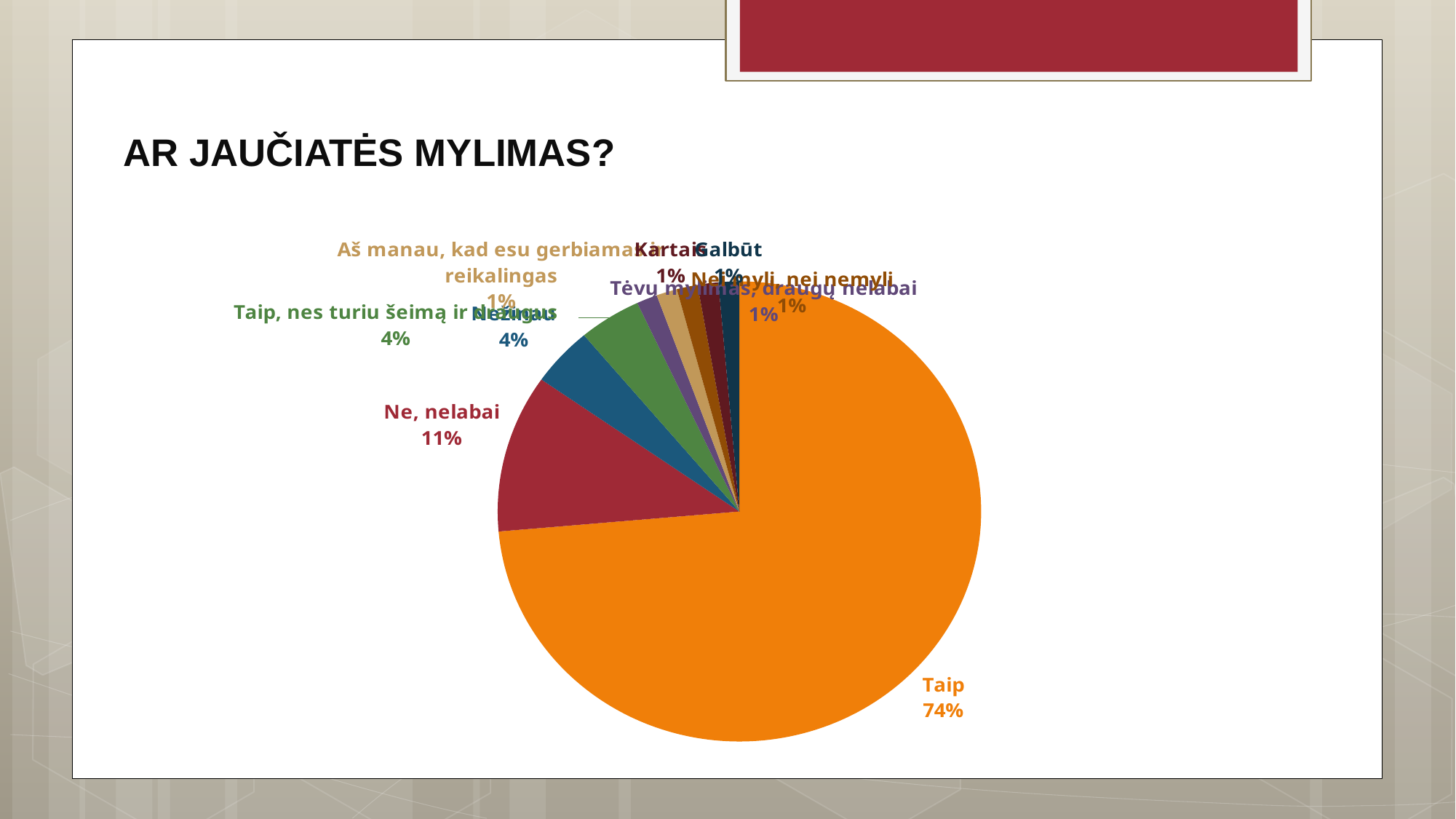
Which category has the largest slice of the pie? Taip What share of the pie does the "Ne, nelabai" slice have? 11% What is the value shown for "Kartais"? 1% What colour is the "Taip" slice? orange How many slices does the pie chart have? 9 What is the value shown for "Nežinau"? 4% What is the value shown for "Galbūt"? 1% Which is larger, the slice for "Ne, nelabai" or the slice for "Nežinau"? Ne, nelabai What kind of chart is shown on the slide? pie chart What share of the pie does the "Taip" slice have? 74% What is the difference between the "Taip" share and the "Ne, nelabai" share? 63% What is the title of the slide's chart? AR JAUČIATĖS MYLIMAS?